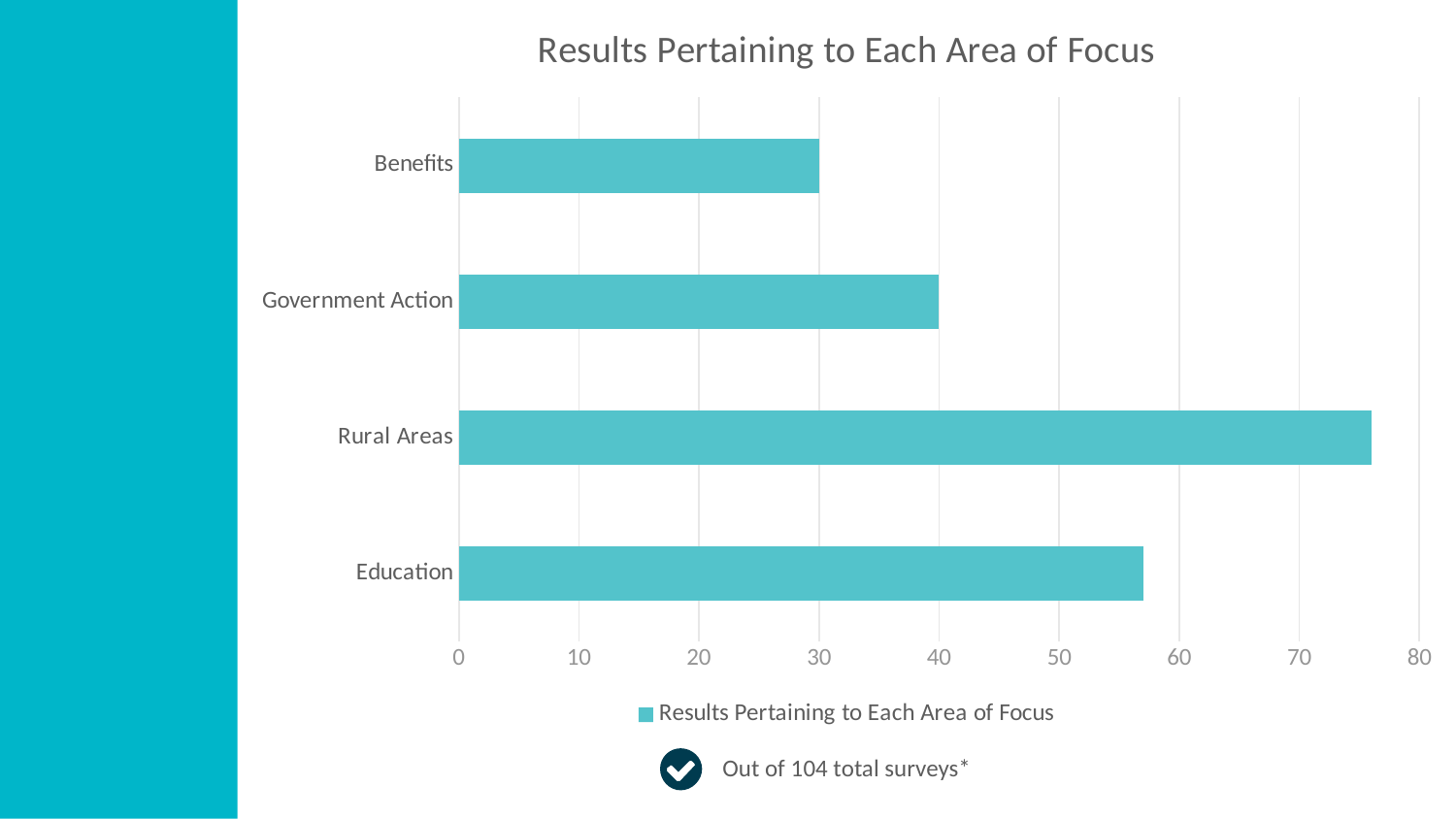
Is the value for Rural Areas greater or less than 70? greater Which area of focus has the highest value? Rural Areas Is the value for Education greater or less than 60? less What type of chart is shown on the slide? bar chart What is the title of the chart? Results Pertaining to Each Area of Focus What is the value for Benefits? 30 What is the value for Government Action? 40 What is the difference between the values for Government Action and Benefits? 10 How many areas of focus are shown in the chart? 4 Which area of focus has the lowest value? Benefits How many series does the legend list? 1 Which is larger, the value for Education or the value for Government Action? Education